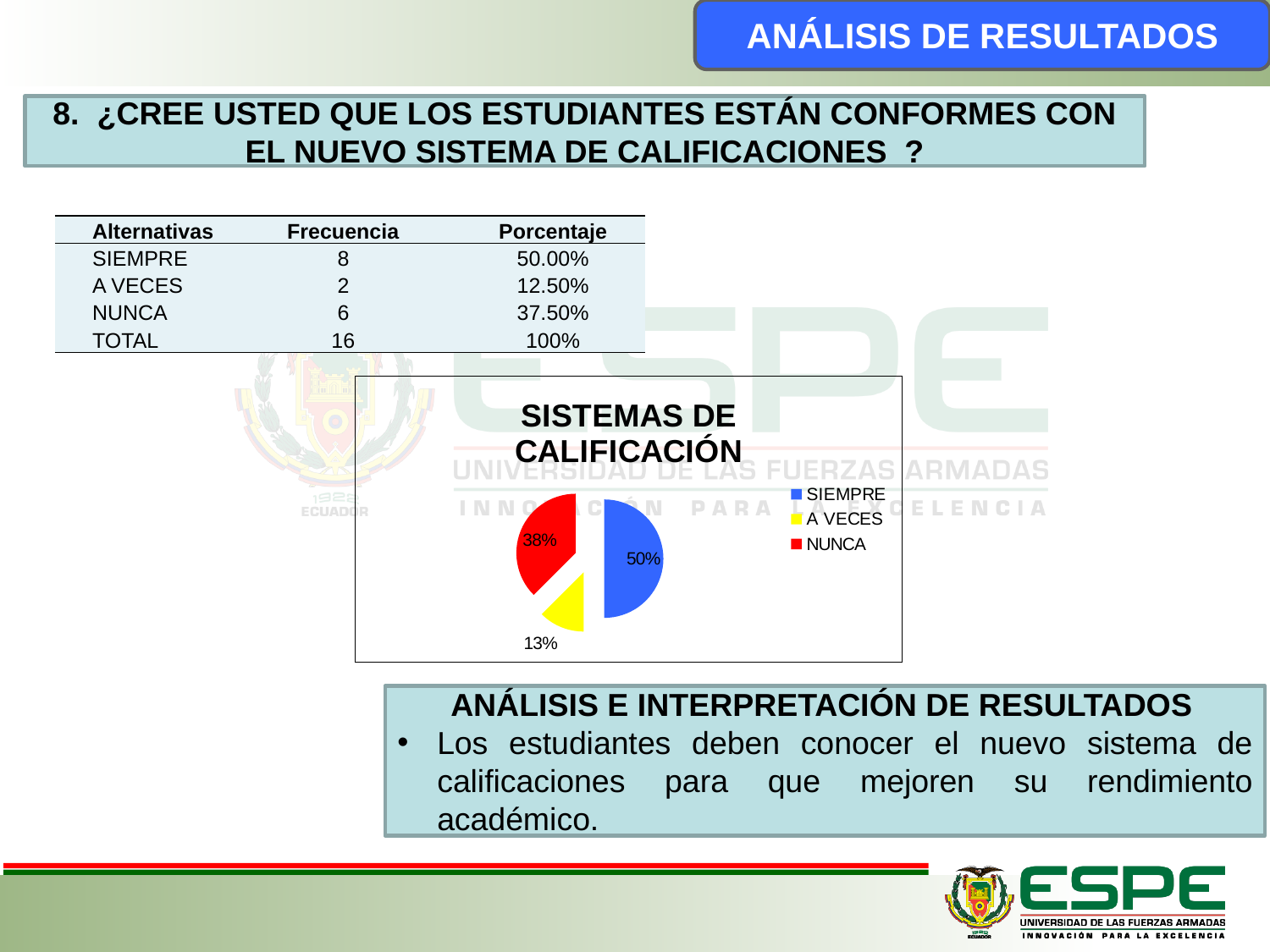
What is the title of the pie chart? SISTEMAS DE CALIFICACIÓN What kind of chart is shown on the slide? pie chart Which is larger in the pie chart, NUNCA or A VECES? NUNCA What is the difference in percentage points between the SIEMPRE and NUNCA slices? 12 Which category has the smallest slice in the pie chart? A VECES How many slices does the pie chart have? 3 What percentage is shown for NUNCA in the pie chart? 38% What percentage is shown for SIEMPRE in the pie chart? 50% Which category has the largest slice in the pie chart? SIEMPRE What percentage is shown for A VECES in the pie chart? 13% How many entries does the legend of the pie chart list? 3 What colour is the NUNCA slice in the pie chart? red